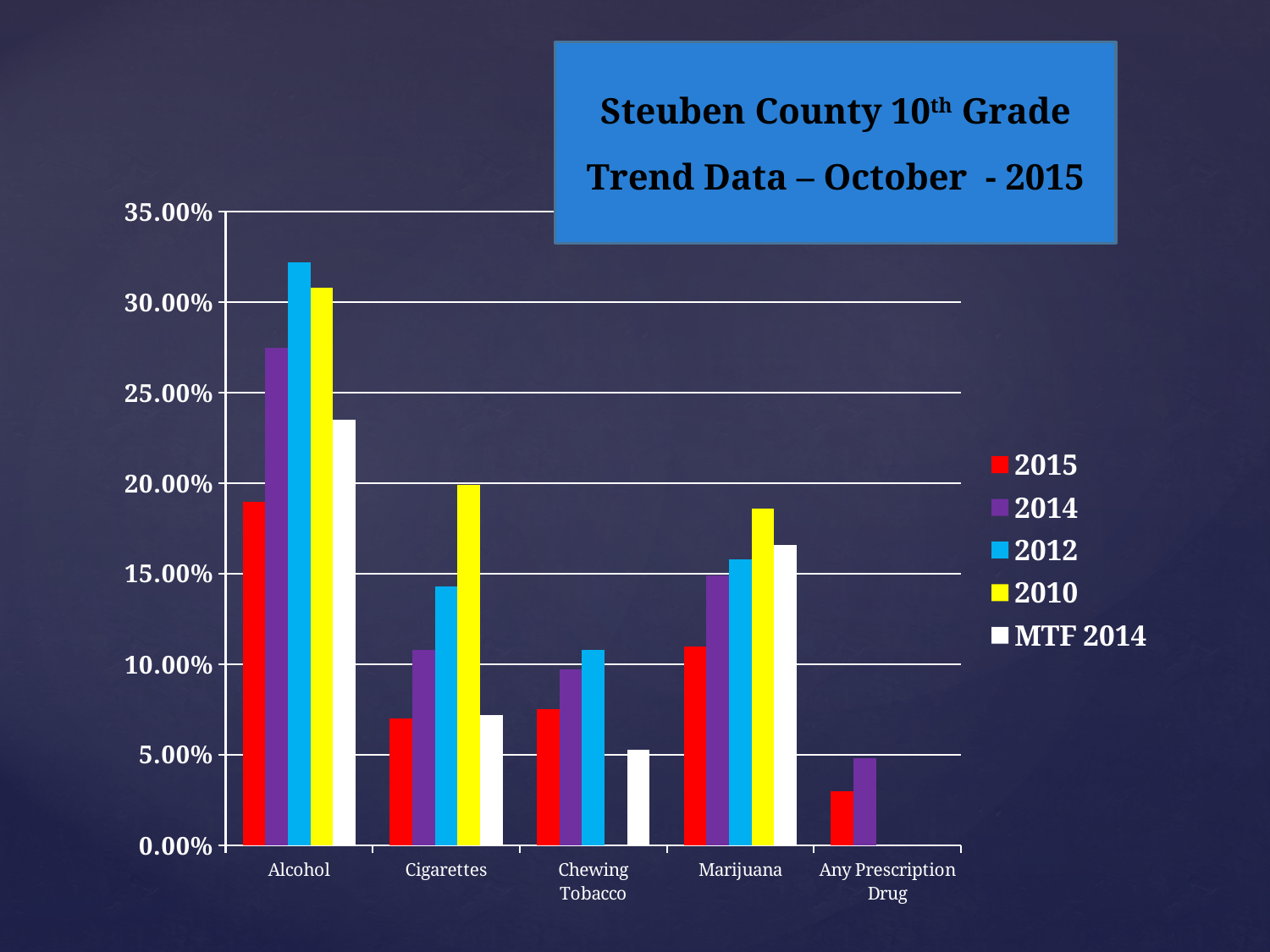
Which category has the highest value for the 2015 series? Alcohol How many series does the legend list? 5 Which series has the highest value for Cigarettes? 2010 Is the 2012 value for Alcohol greater or less than 30.00%? greater What kind of chart is shown on the slide? bar chart Is the 2015 value for Cigarettes greater or less than 10.00%? less For Alcohol, which is larger: the 2014 value or the MTF 2014 value? 2014 Is the MTF 2014 value for Chewing Tobacco greater or less than 10.00%? less What is the title of the chart? Steuben County 10th Grade Trend Data – October - 2015 How many categories are shown on the x axis? 5 Which category has the lowest value for the 2015 series? Any Prescription Drug